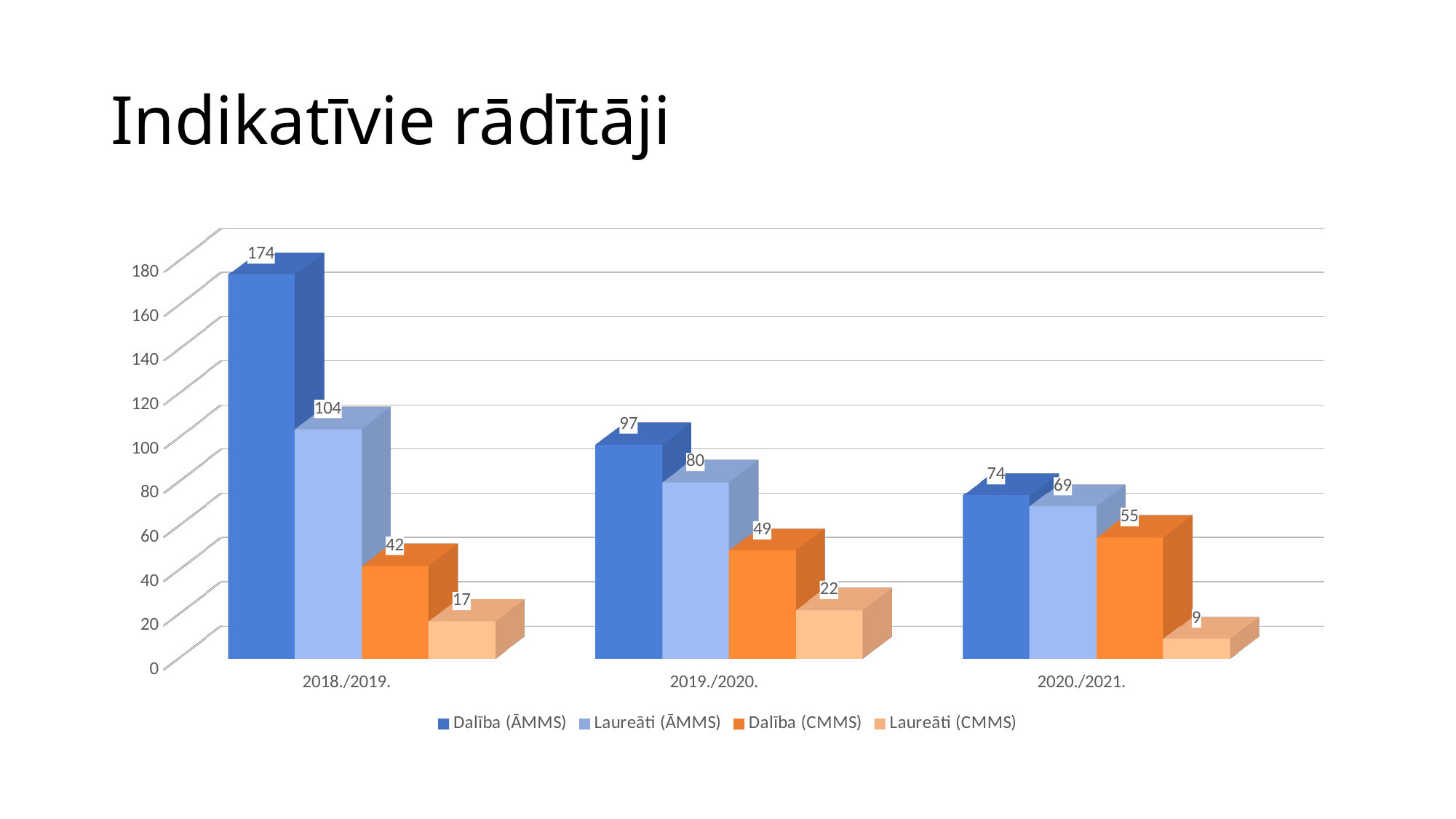
What is the value for Dalība (CMMS) in 2019./2020.? 49 What kind of chart is shown on the slide? Bar chart Which year has the highest value for Dalība (ĀMMS)? 2018./2019. Which year has the lowest value for Laureāti (CMMS)? 2020./2021. What is the value for Dalība (ĀMMS) in 2018./2019.? 174 How many series does the legend list? 4 How many year categories are shown on the x axis? 3 Which is larger: Dalība (CMMS) in 2020./2021. or Dalība (CMMS) in 2019./2020.? Dalība (CMMS) in 2020./2021. What is the value for Laureāti (CMMS) in 2020./2021.? 9 What is the title of the slide? Indikatīvie rādītāji What is the difference between Dalība (ĀMMS) and Laureāti (ĀMMS) in 2018./2019.? 70 Does the value for Laureāti (ĀMMS) rise or fall from 2018./2019. to 2020./2021.? Fall